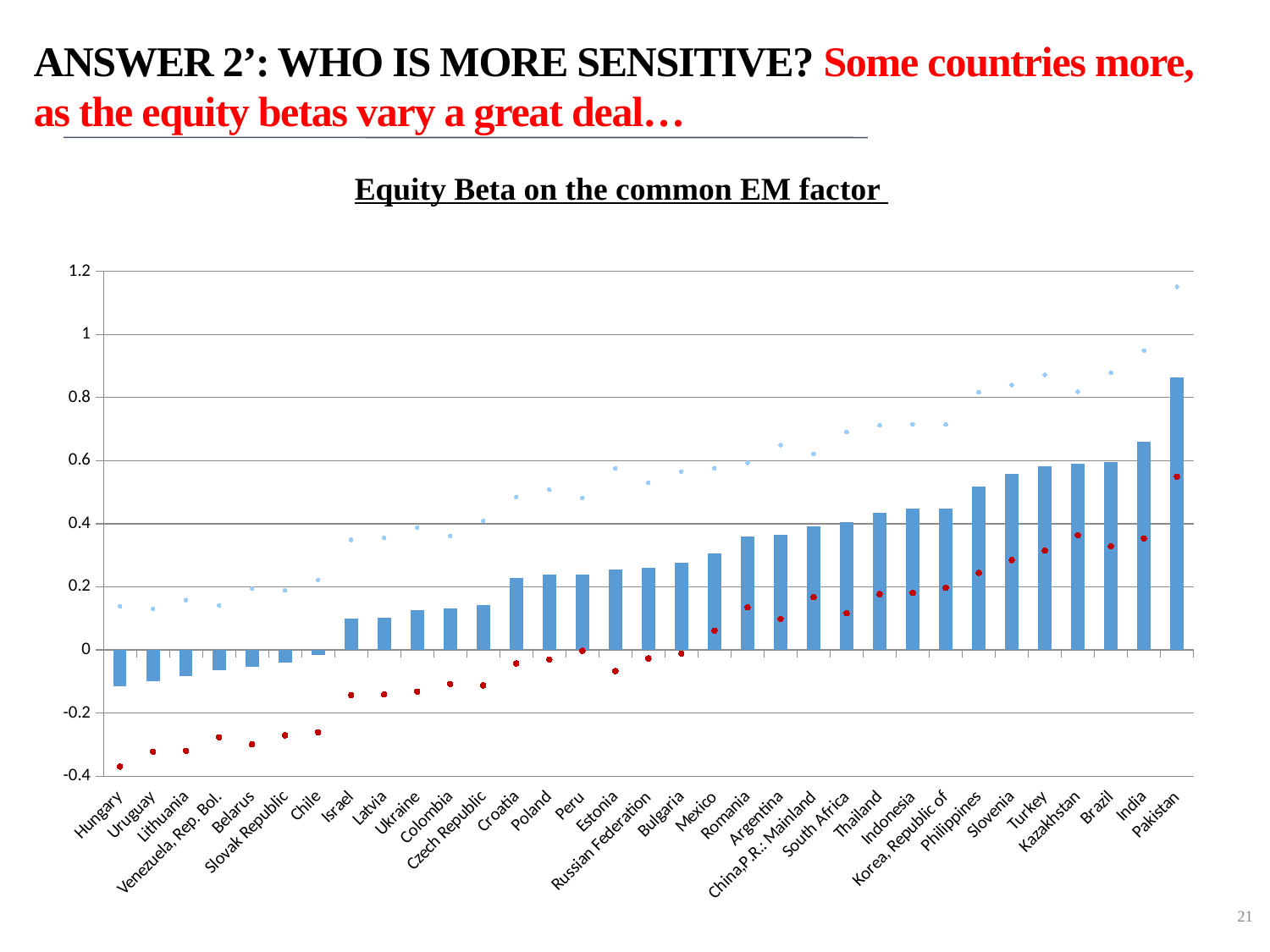
Which country has the highest equity beta bar? Pakistan What is the highest value shown on the y axis? 1.2 What kind of chart is shown on the slide? bar chart Which has the larger bar, Thailand or Croatia? Thailand Do the bars generally rise or fall moving from left to right along the x axis? rise Is the bar for Hungary greater or less than 0? less Is the bar for Philippines greater or less than 0.4? greater Is the bar for India greater or less than 0.6? greater How many countries are shown on the x axis of the chart? 33 What is the title of the chart? Equity Beta on the common EM factor